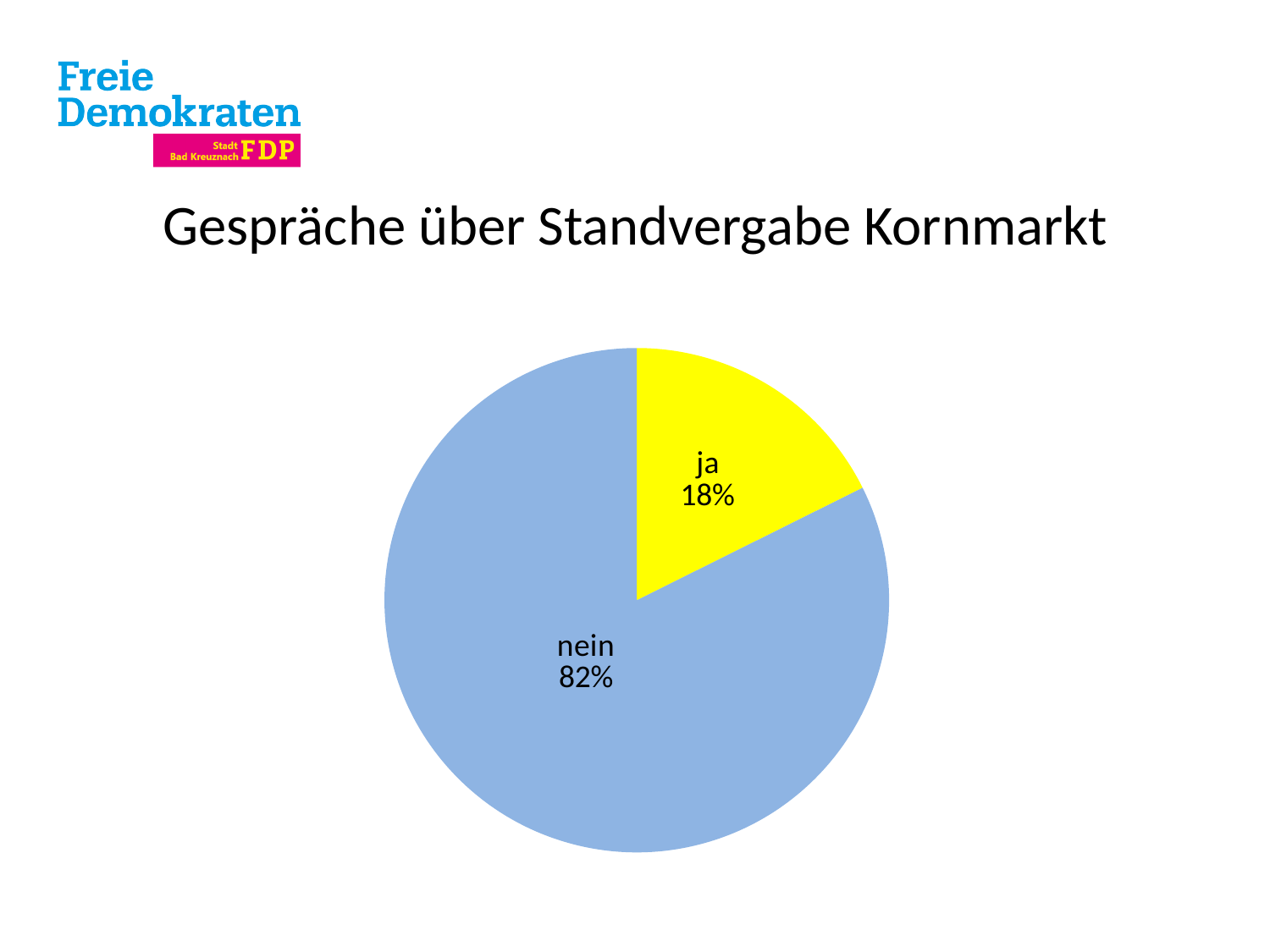
What share of the pie does the "nein" slice represent? 82% What is the title of the chart on the slide? Gespräche über Standvergabe Kornmarkt How many slices does the pie chart have? 2 What is the difference in percentage points between the "nein" and "ja" slices? 64 Which slice is the smallest in the pie chart? ja Which slice is larger, "ja" or "nein"? nein Which slice is the largest in the pie chart? nein What kind of chart is shown on the slide? pie chart What colour is the "ja" slice in the pie chart? yellow What share of the pie does the "ja" slice represent? 18% Is the share for "nein" greater or less than 50%? greater